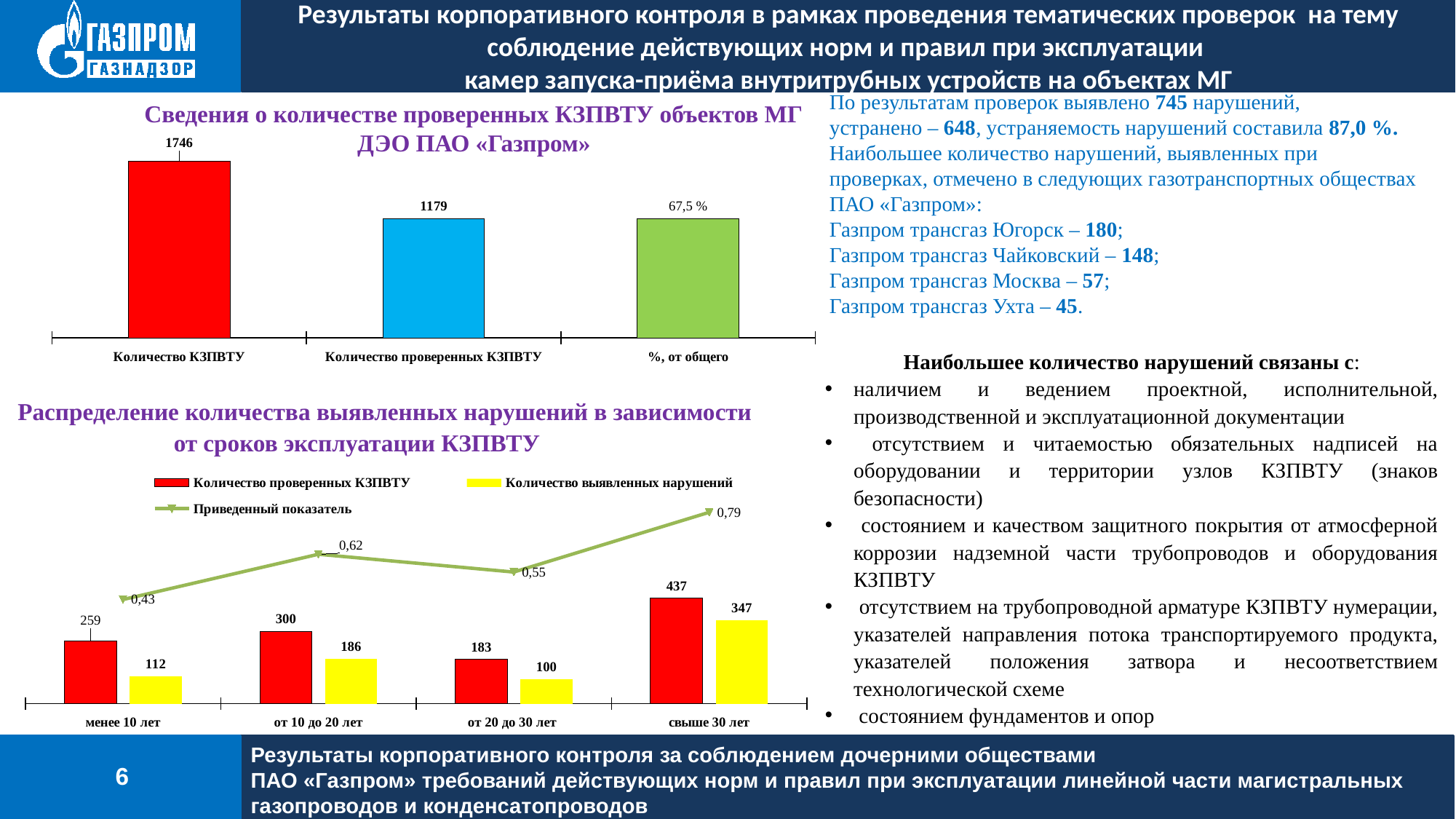
What kind of chart is the top chart «Сведения о количестве проверенных КЗПВТУ объектов МГ ДЭО ПАО «Газпром»»? Bar chart In the top chart «Сведения о количестве проверенных КЗПВТУ объектов МГ ДЭО ПАО «Газпром»», what is the value labelled «%, от общего»? 67,5 % In the bottom chart «Распределение количества выявленных нарушений в зависимости от сроков эксплуатации КЗПВТУ», what is the difference between «Количество проверенных КЗПВТУ» and «Количество выявленных нарушений» for «менее 10 лет»? 147 In the bottom chart «Распределение количества выявленных нарушений в зависимости от сроков эксплуатации КЗПВТУ», how many categories are shown on the x axis? 4 In the bottom chart «Распределение количества выявленных нарушений в зависимости от сроков эксплуатации КЗПВТУ», what is the value of «Приведенный показатель» for «от 10 до 20 лет»? 0,62 In the top chart «Сведения о количестве проверенных КЗПВТУ объектов МГ ДЭО ПАО «Газпром»», what is the difference between «Количество КЗПВТУ» and «Количество проверенных КЗПВТУ»? 567 In the top chart «Сведения о количестве проверенных КЗПВТУ объектов МГ ДЭО ПАО «Газпром»», what is the value for «Количество КЗПВТУ»? 1746 In the bottom chart «Распределение количества выявленных нарушений в зависимости от сроков эксплуатации КЗПВТУ», which category has the highest «Количество проверенных КЗПВТУ»? свыше 30 лет How many series does the legend of the bottom chart «Распределение количества выявленных нарушений в зависимости от сроков эксплуатации КЗПВТУ» list? 3 In the top chart «Сведения о количестве проверенных КЗПВТУ объектов МГ ДЭО ПАО «Газпром»», what is the value for «Количество проверенных КЗПВТУ»? 1179 In the bottom chart «Распределение количества выявленных нарушений в зависимости от сроков эксплуатации КЗПВТУ», which category has the lowest «Количество выявленных нарушений»? от 20 до 30 лет In the bottom chart «Распределение количества выявленных нарушений в зависимости от сроков эксплуатации КЗПВТУ», what is the value of «Количество выявленных нарушений» for «свыше 30 лет»? 347